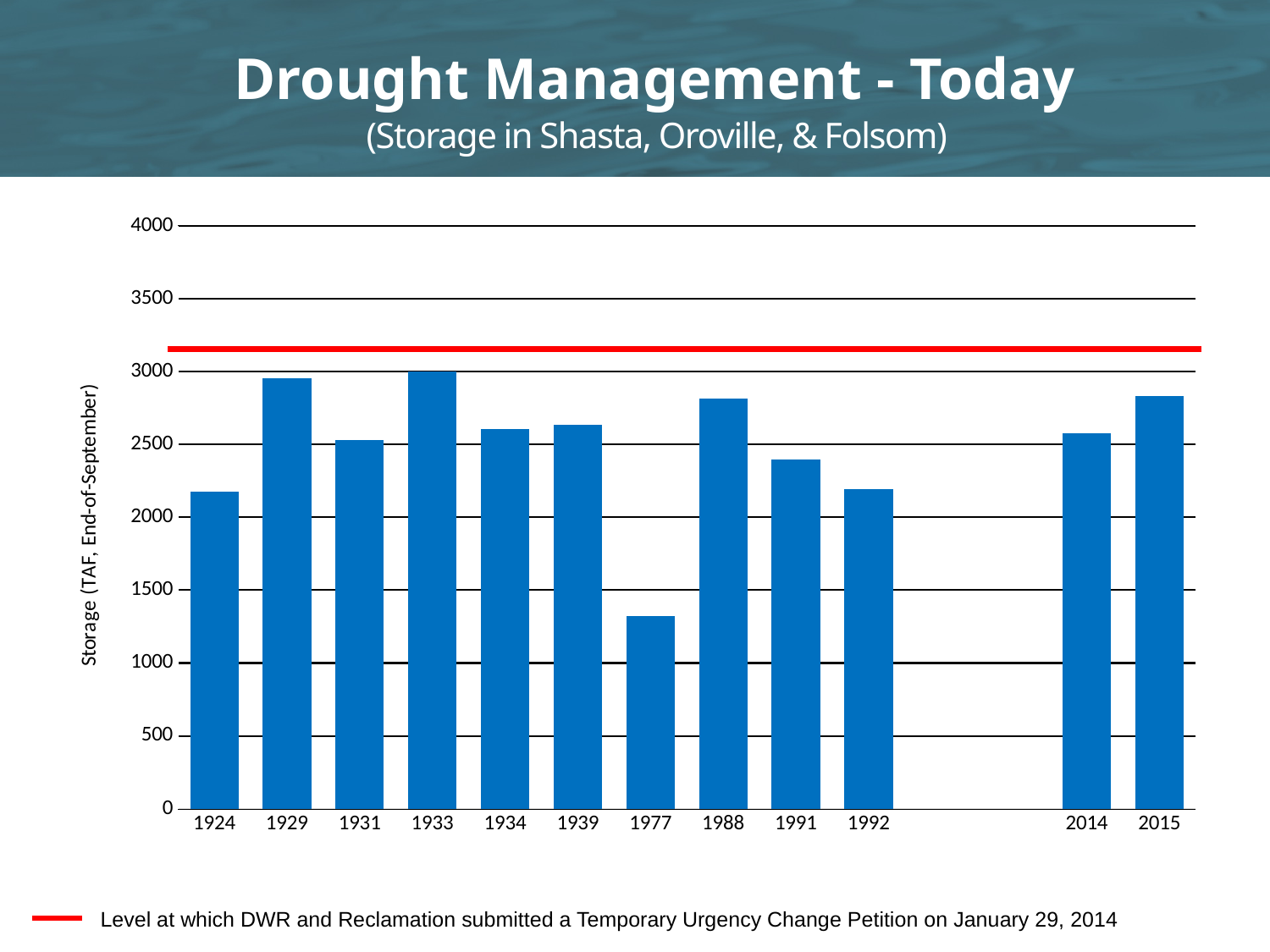
Is the storage value for 1924 greater or less than 2000? greater What is the label on the vertical axis of the chart? Storage (TAF, End-of-September) What kind of chart is shown on the slide? Bar chart Is the storage value for 1988 greater or less than 2500? greater Is the storage value for 2015 greater or less than 2500? greater Which year has the larger storage value, 1991 or 1992? 1991 Which year has the larger storage value, 2014 or 2015? 2015 According to the legend, what does the red horizontal line on the chart represent? Level at which DWR and Reclamation submitted a Temporary Urgency Change Petition on January 29, 2014 Which year has the lowest storage in the chart? 1977 How many years (bars) are plotted in the chart? 12